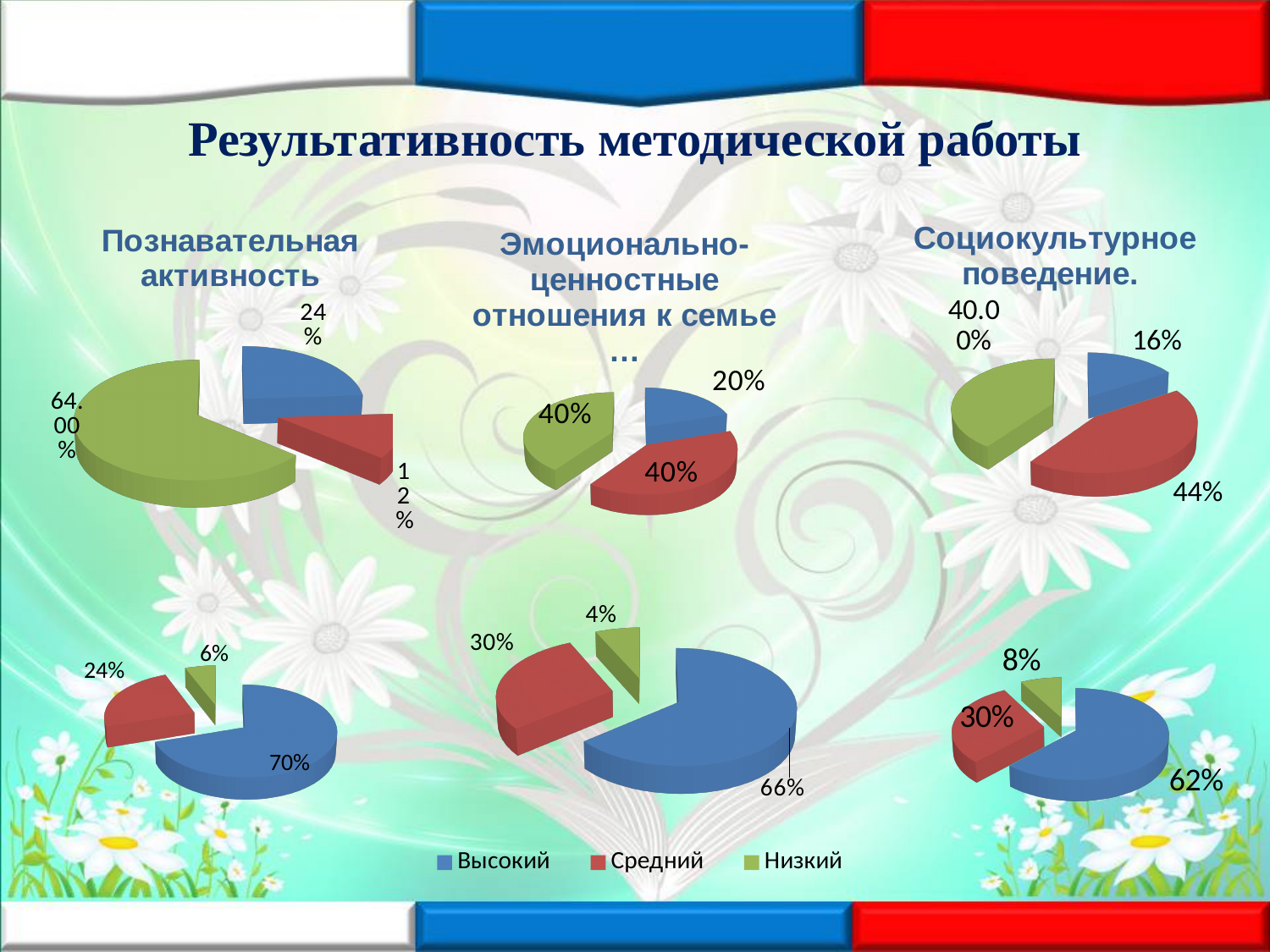
In the bottom-left pie chart, what is the value of the 'Высокий' slice? 70% In the 'Социокультурное поведение.' pie chart, what is the value of the 'Высокий' slice? 16% In the 'Эмоционально-ценностные отношения к семье…' pie chart, what is the difference between the 'Средний' and 'Высокий' slices? 20% In the bottom-right pie chart, which is larger: the 'Средний' slice or the 'Низкий' slice? Средний In the 'Познавательная активность' pie chart, what is the value of the 'Низкий' slice? 64.00% In the 'Эмоционально-ценностные отношения к семье…' pie chart, which category has the smallest slice? Высокий How many series does the legend at the bottom of the slide list? 3 What type of chart is used for 'Познавательная активность'? Pie chart In the 'Социокультурное поведение.' pie chart, which category has the largest slice? Средний In the 'Познавательная активность' pie chart, what is the value of the 'Высокий' slice? 24% In the bottom-middle pie chart, what is the value of the 'Низкий' slice? 4% In the bottom-right pie chart, what is the difference between the 'Высокий' and 'Средний' slices? 32%